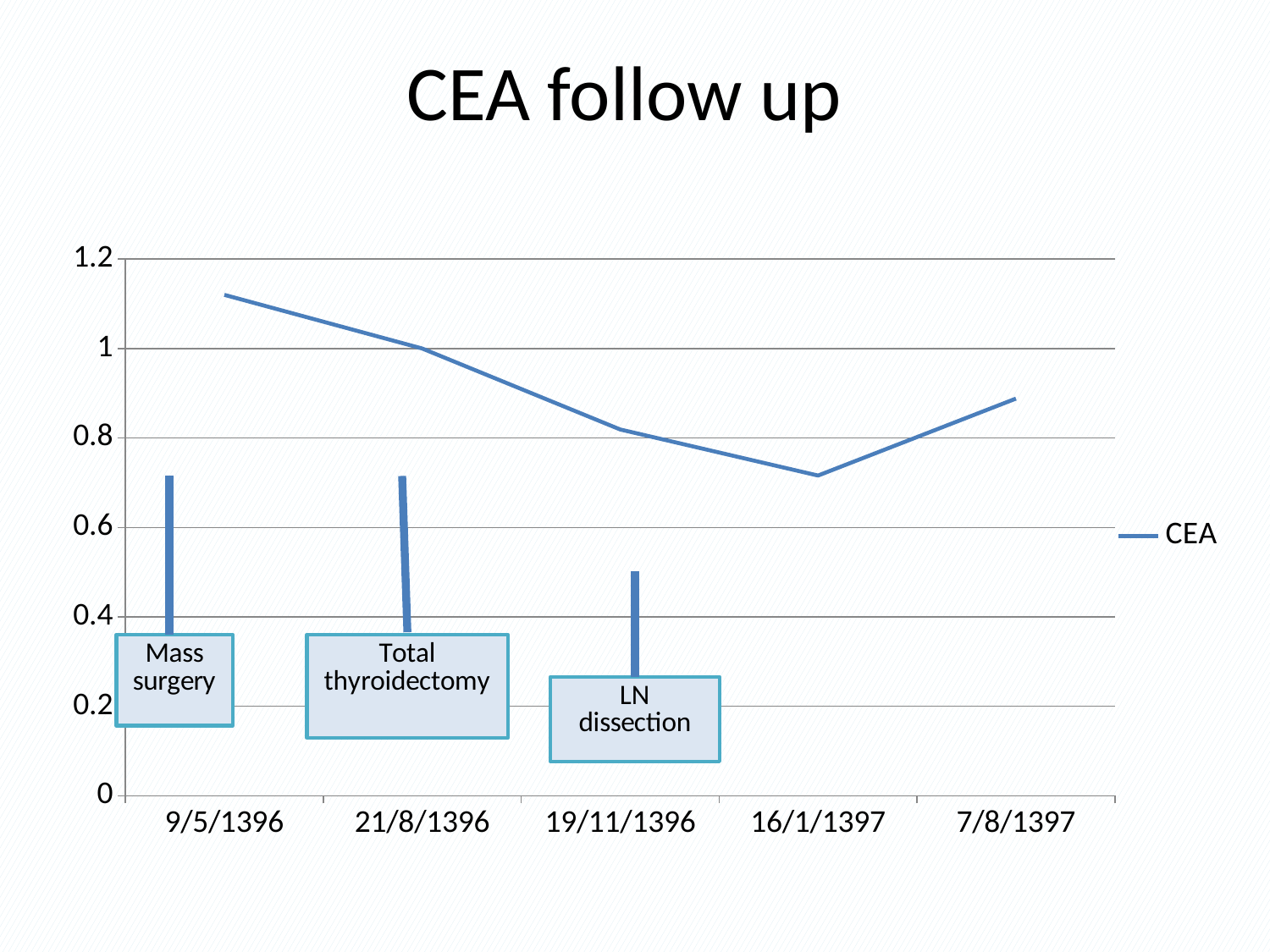
What type of chart is shown on the slide? line chart How many dates are plotted on the x axis? 5 Is the CEA value for 7/8/1397 greater or less than 1? less What event is annotated on the chart at 19/11/1396? LN dissection Which has the larger CEA value, 9/5/1396 or 7/8/1397? 9/5/1396 On which date is the CEA value highest? 9/5/1396 Is the CEA value for 16/1/1397 greater or less than 0.8? less Does the CEA value rise or fall from 9/5/1396 to 16/1/1397? fall Is the CEA value for 9/5/1396 greater or less than 1? greater On which date is the CEA value lowest? 16/1/1397 How many series does the legend list? 1 What is the title of the chart? CEA follow up